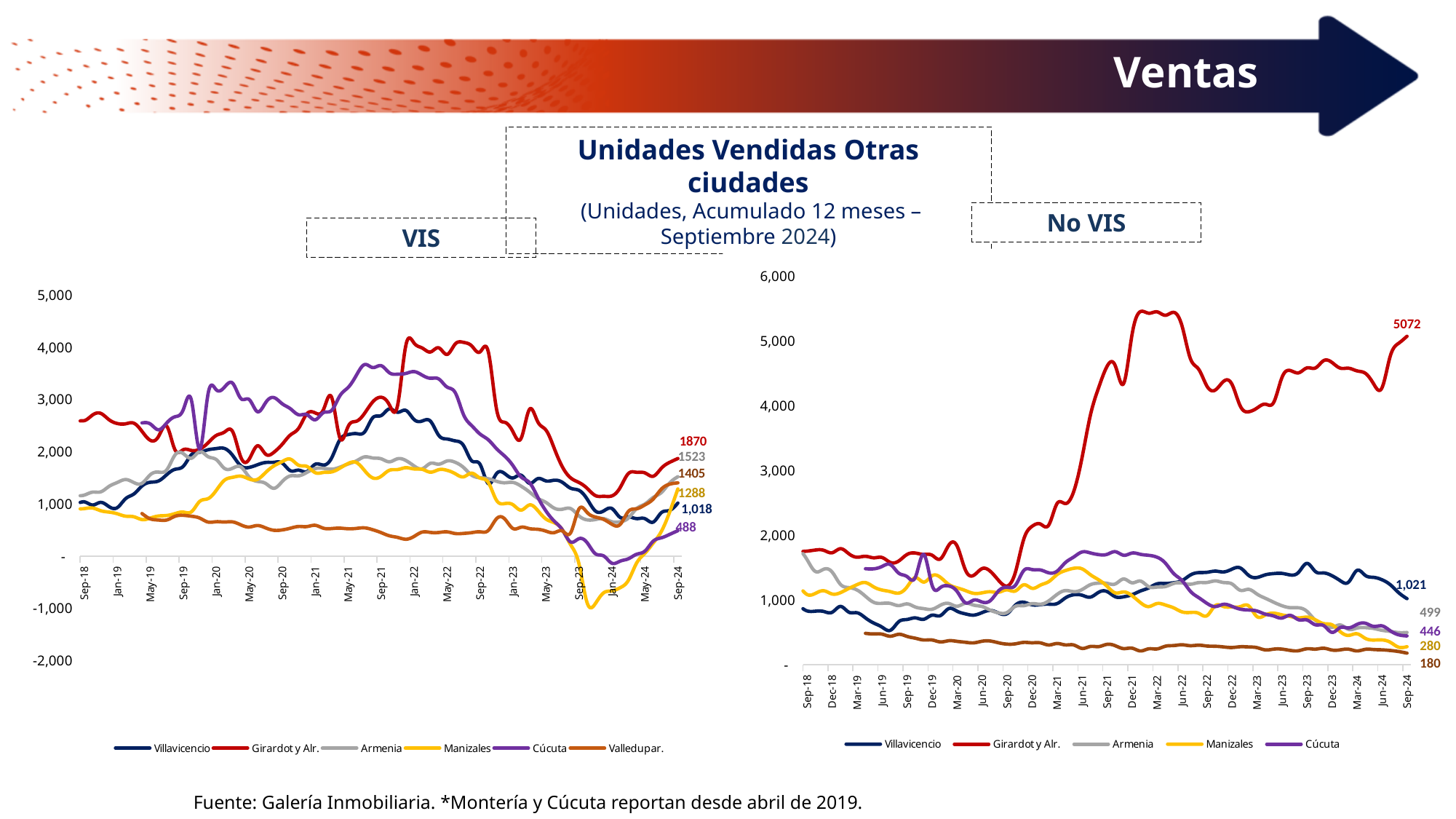
On the VIS chart, what is the value for Valledupar at Sep-24? 1405 On the VIS chart, which series has the highest value at Sep-24? Girardot y Alr. What kind of chart is the No VIS chart? line chart On the VIS chart, what is the difference between the Sep-24 values of Girardot y Alr. and Armenia? 347 On the VIS chart, which series has the lowest value at Sep-24? Cúcuta On the No VIS chart, what is the value for Girardot y Alr. at Sep-24? 5072 On the VIS chart, what is the value for Cúcuta at Sep-24? 488 On the No VIS chart, which is larger at Sep-24: Armenia or Cúcuta? Armenia On the VIS chart, what is the value for Girardot y Alr. at Sep-24? 1870 How many series does the legend of the VIS chart list? 6 On the No VIS chart, what is the value for Villavicencio at Sep-24? 1,021 On the No VIS chart, is the peak value of Girardot y Alr. greater or less than 5,000? greater